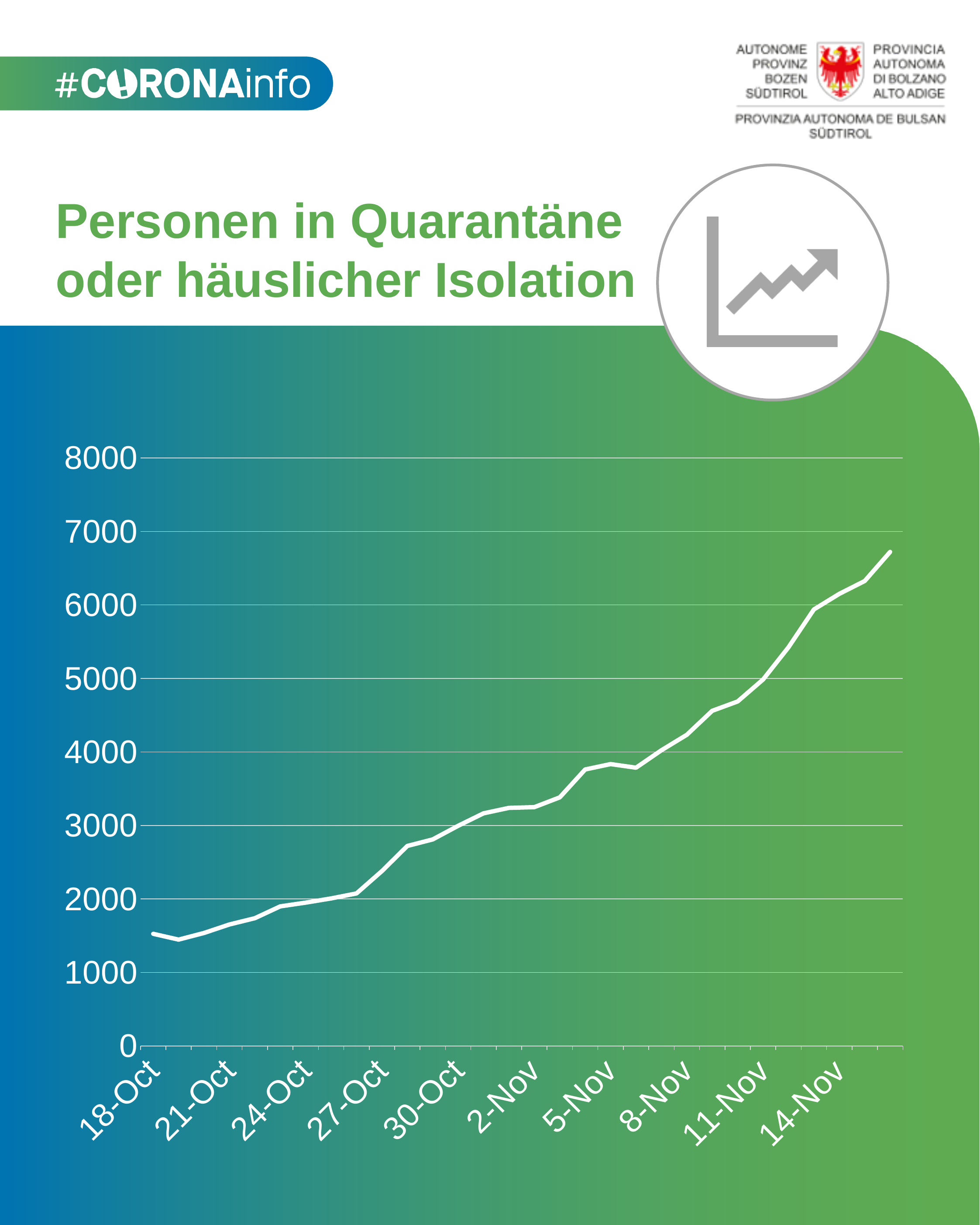
Which date has the larger value, 2-Nov or 8-Nov? 8-Nov Is the last value on the line greater or less than 7000? less Which date has the larger value, 18-Oct or 14-Nov? 14-Nov Is the value for 8-Nov greater or less than 4000? greater Is the value for 2-Nov greater or less than 3000? greater What kind of chart is shown on the slide? line chart What is the title of the slide's chart? Personen in Quarantäne oder häuslicher Isolation Do the values rise or fall from 18-Oct to 14-Nov? rise How many date labels are shown on the x axis? 10